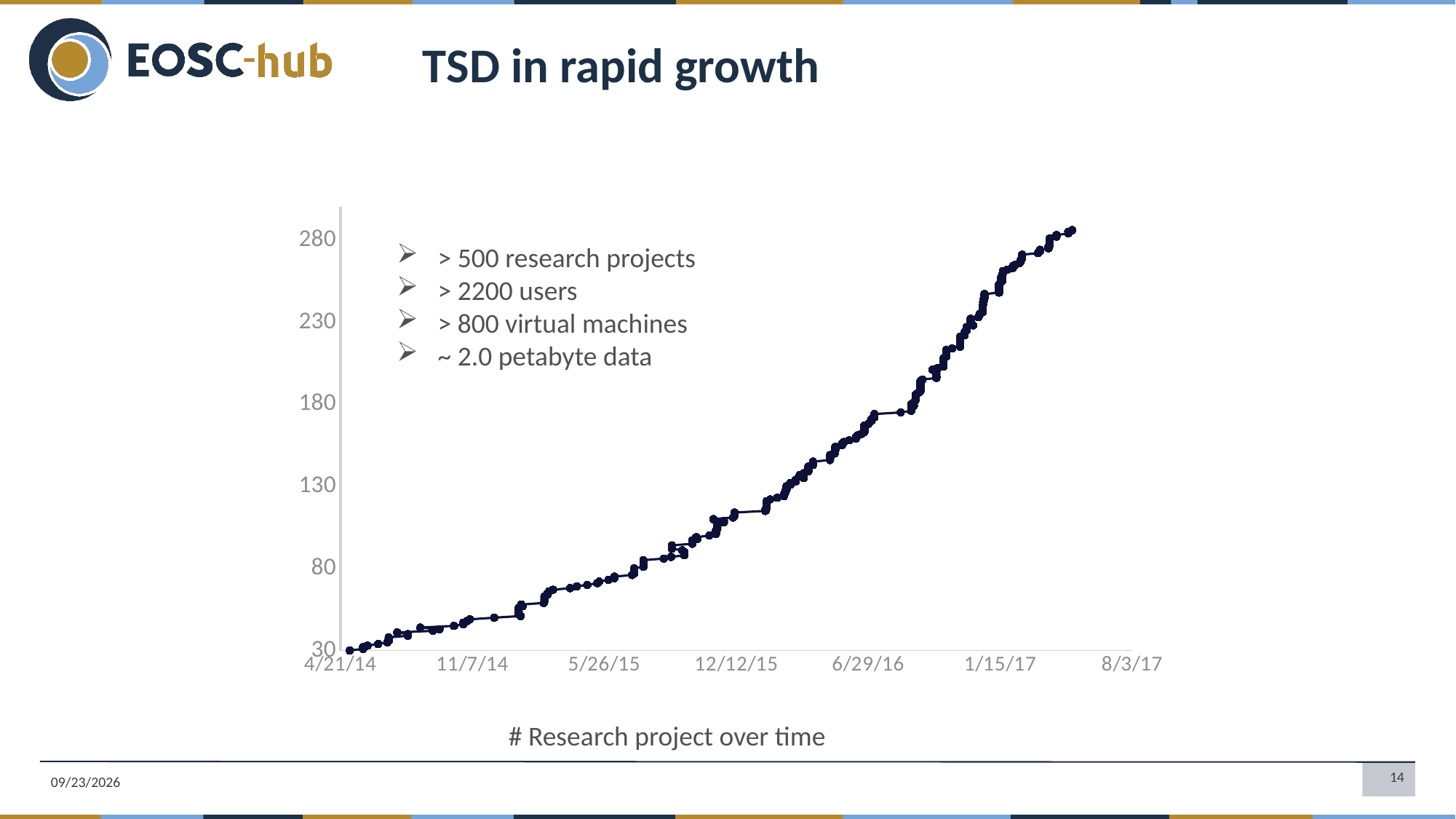
What is the value of the first plotted point, at 4/21/14? 30 Do the values rise or fall over time along the x axis? rise What kind of chart is shown on the slide? line chart Is the value around 1/15/17 greater or less than 230? greater Is the value around 12/12/15 greater or less than 80? greater Is the value around 11/7/14 greater or less than 80? less What is the title shown below the chart? # Research project over time What is the first date label on the x axis of the chart? 4/21/14